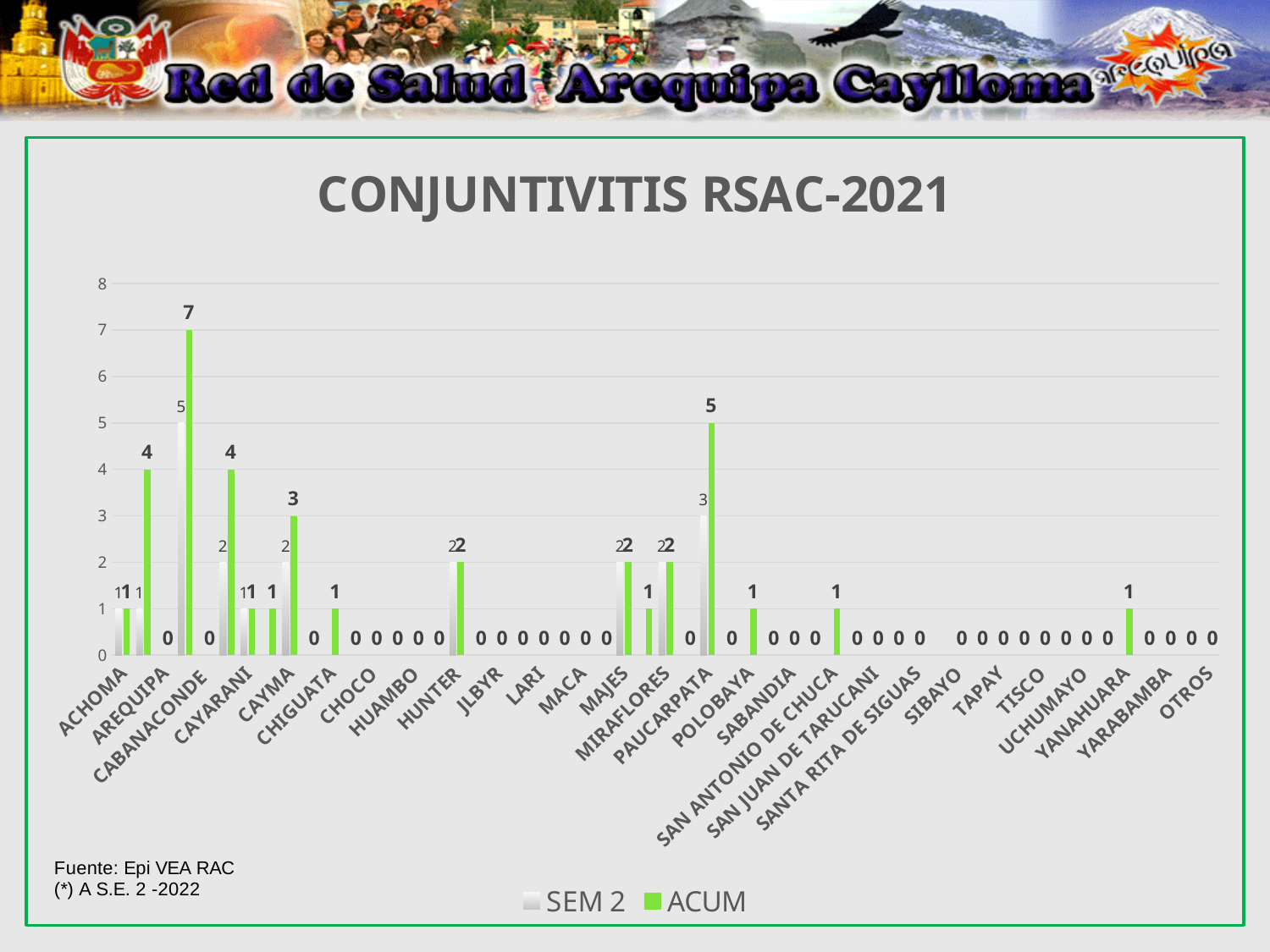
What are the two series named in the legend? SEM 2 and ACUM How many series does the legend list? 2 What is the ACUM value for HUNTER? 2 What is the difference between the ACUM and SEM 2 values for PAUCARPATA? 2 What is the ACUM value for PAUCARPATA? 5 What is the highest value labelled on any bar in the chart? 7 What is the ACUM value for OTROS? 0 What is the SEM 2 value for PAUCARPATA? 3 Which has the larger ACUM value, PAUCARPATA or CAYMA? PAUCARPATA What is the ACUM value for YANAHUARA? 1 What is the title of the chart? CONJUNTIVITIS RSAC-2021 What type of chart is shown on the slide? bar chart